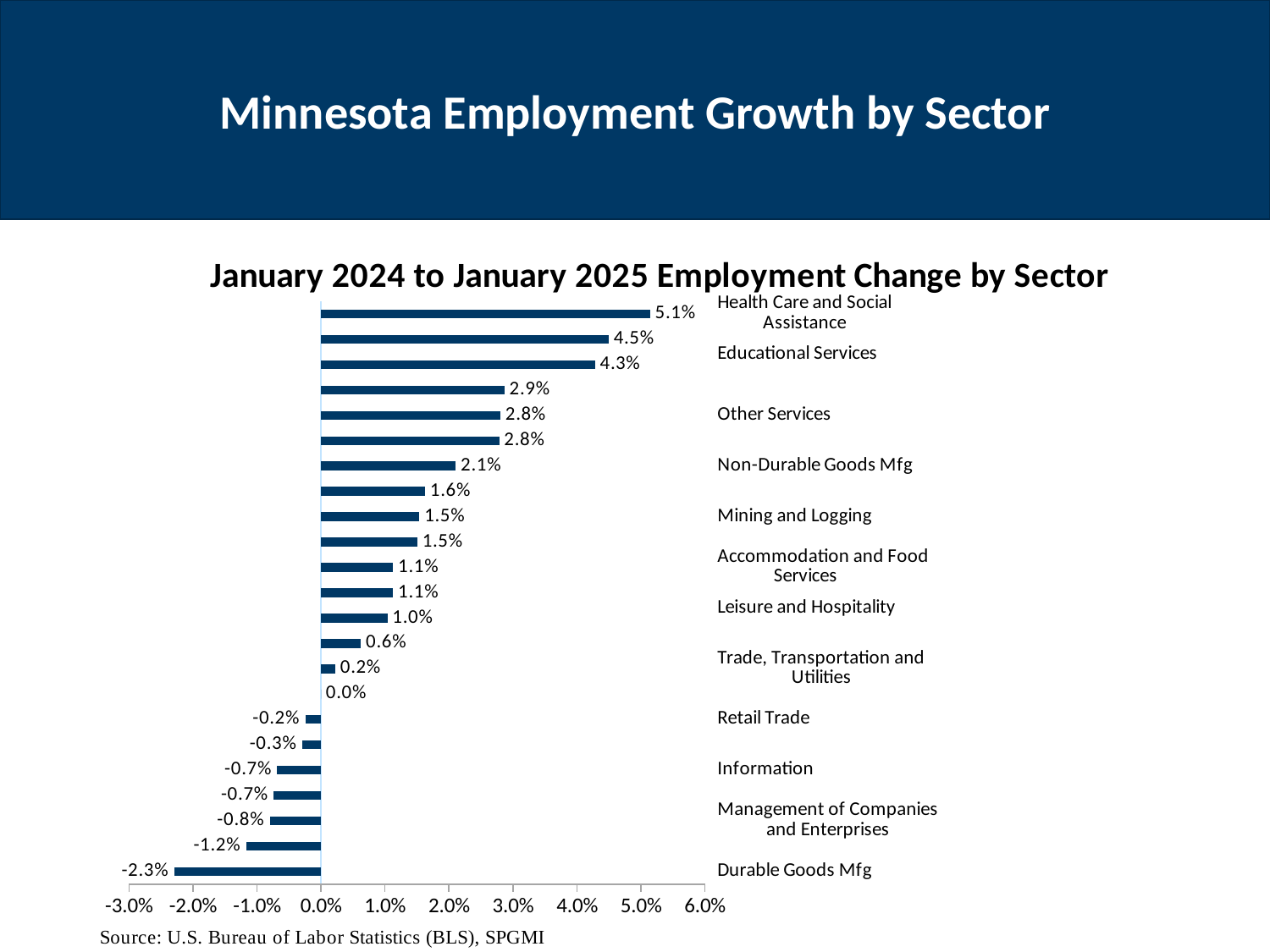
What is the employment change for Retail Trade? -0.2% What is the employment change for Information? -0.7% Which has a larger employment change, Mining and Logging or Retail Trade? Mining and Logging What is the employment change for Non-Durable Goods Mfg? 2.1% What is the employment change for Other Services? 2.8% Which sector has the highest employment change? Health Care and Social Assistance What is the employment change for Durable Goods Mfg? -2.3% What is the difference in percentage points between Other Services and Non-Durable Goods Mfg? 0.7 percentage points Which sector has the lowest employment change? Durable Goods Mfg Is the value for Educational Services greater or less than 4.0%? greater What is the employment change for Health Care and Social Assistance? 5.1% What kind of chart is shown on the slide? Bar chart